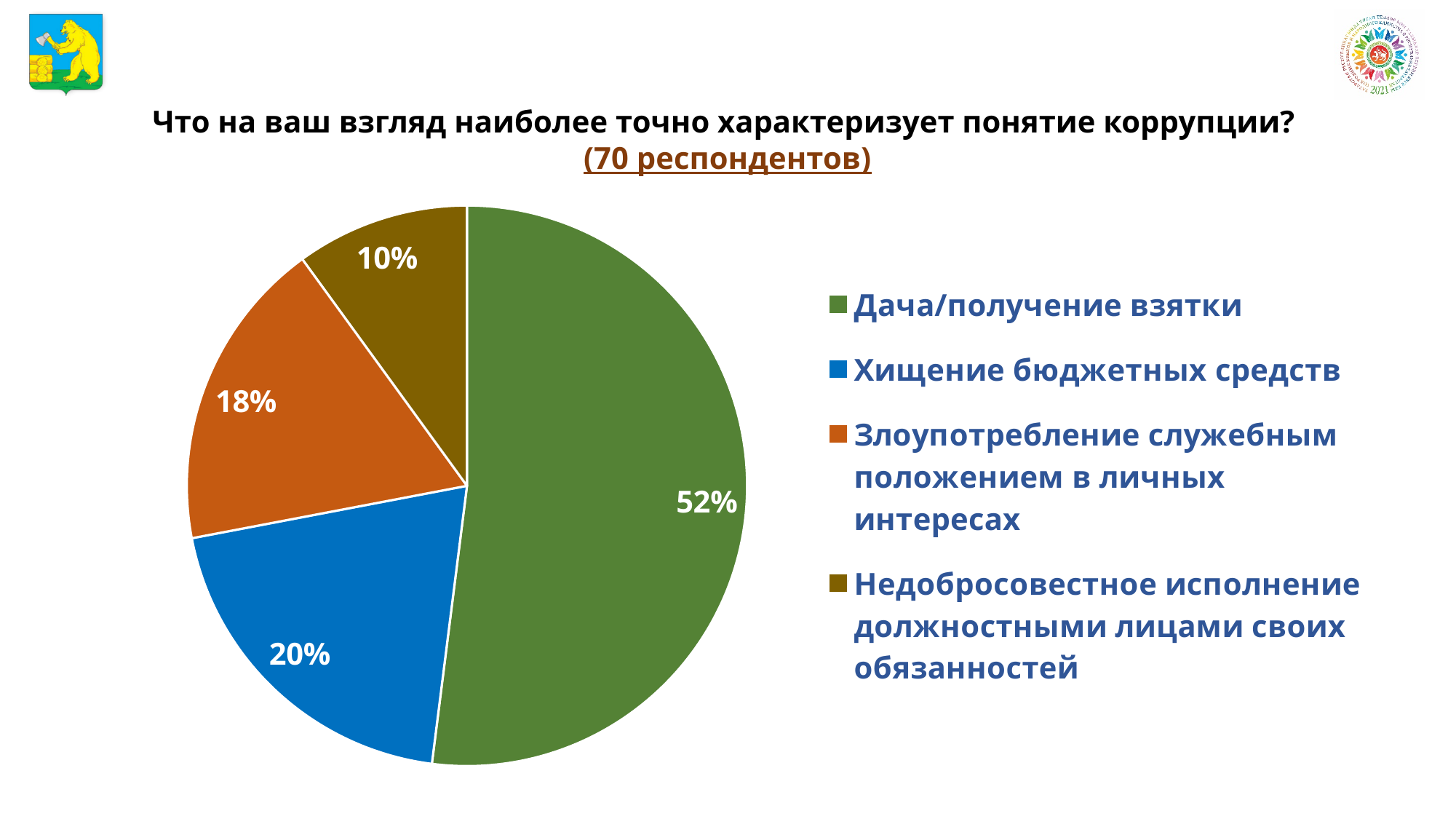
What share of the pie does "Дача/получение взятки" account for? 52% What is the difference between the shares for "Дача/получение взятки" and "Хищение бюджетных средств"? 32% What type of chart is shown on the slide? Pie chart Which is larger: the share for "Хищение бюджетных средств" or for "Злоупотребление служебным положением в личных интересах"? Хищение бюджетных средств What is the difference between the shares for "Злоупотребление служебным положением в личных интересах" and "Недобросовестное исполнение должностными лицами своих обязанностей"? 8% Which category has the smallest slice of the pie? Недобросовестное исполнение должностными лицами своих обязанностей What is the value shown for "Недобросовестное исполнение должностными лицами своих обязанностей"? 10% What is the value shown for "Злоупотребление служебным положением в личных интересах"? 18% How many respondents does the chart title say took part in the survey? 70 Which category has the largest slice of the pie? Дача/получение взятки What is the value shown for "Хищение бюджетных средств"? 20% How many categories does the pie chart show? 4